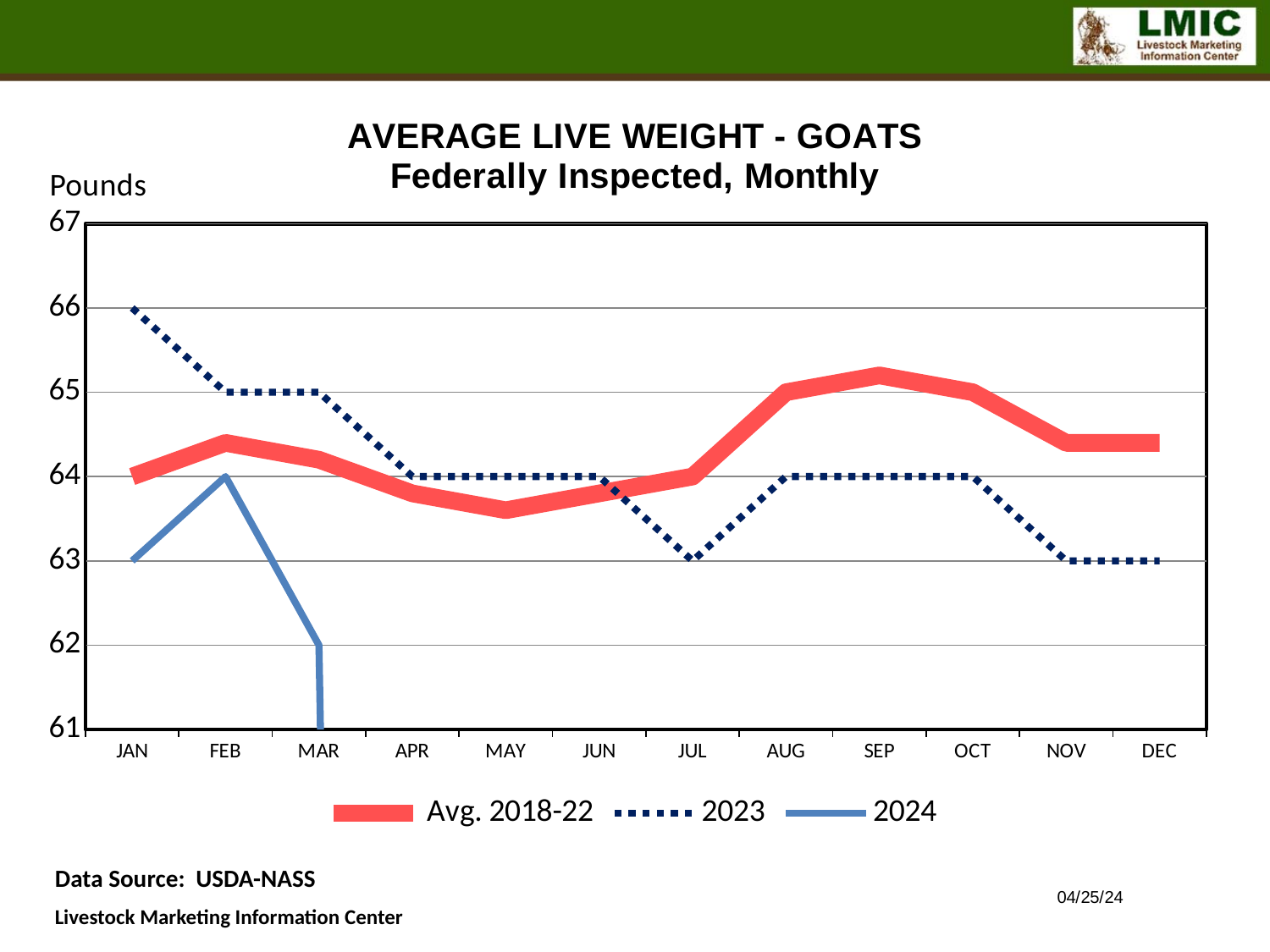
What is the 2023 value for JAN? 66 What is the 2024 value for MAR? 62 Which is larger in SEP, the Avg. 2018-22 value or the 2023 value? Avg. 2018-22 What is the 2023 value for JUL? 63 Is the Avg. 2018-22 value for SEP greater or less than 65? greater In which month is the 2023 series highest? JAN In which month is the 2024 series lowest? MAR What is the 2024 value for FEB? 64 What is the difference between the 2023 value for JAN and the 2023 value for DEC? 3 What kind of chart is shown on the slide? line chart How many series does the legend list? 3 How many months are shown on the x axis? 12